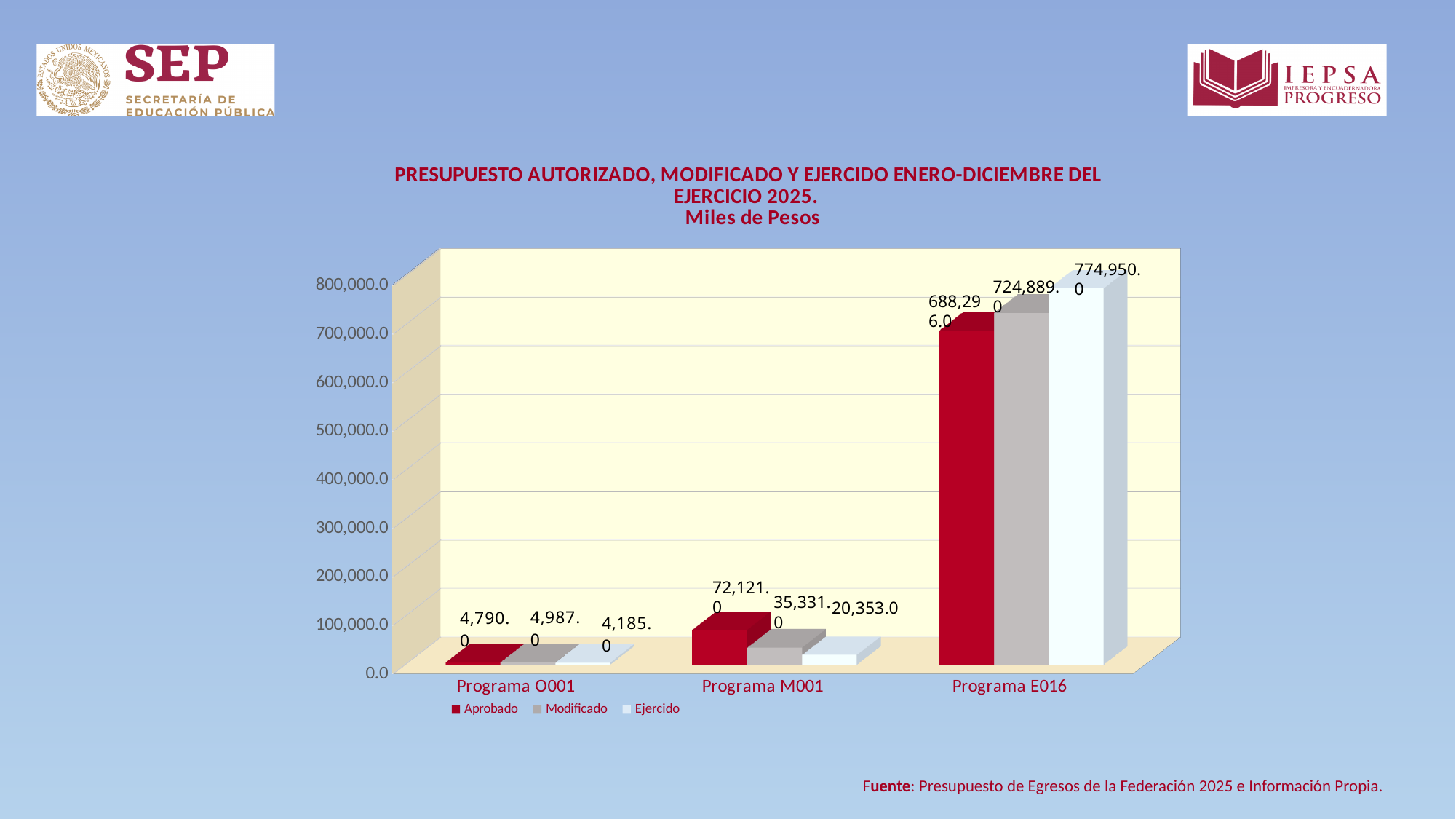
Which program has the lowest Ejercido value? Programa O001 What is the difference between the Aprobado and Ejercido values for Programa M001? 51,768.0 What is the Aprobado value for Programa M001? 72,121.0 Is the Modificado value for Programa E016 greater or less than 700,000.0? greater What kind of chart is shown on the slide? Bar chart What is the Modificado value for Programa O001? 4,987.0 Which program has the highest Aprobado value? Programa E016 What is the Ejercido value for Programa E016? 774,950.0 What is the Modificado value for Programa E016? 724,889.0 How many series does the legend list? 3 For Programa E016, which is larger: the Aprobado value or the Ejercido value? Ejercido How many programs are shown on the x axis? 3